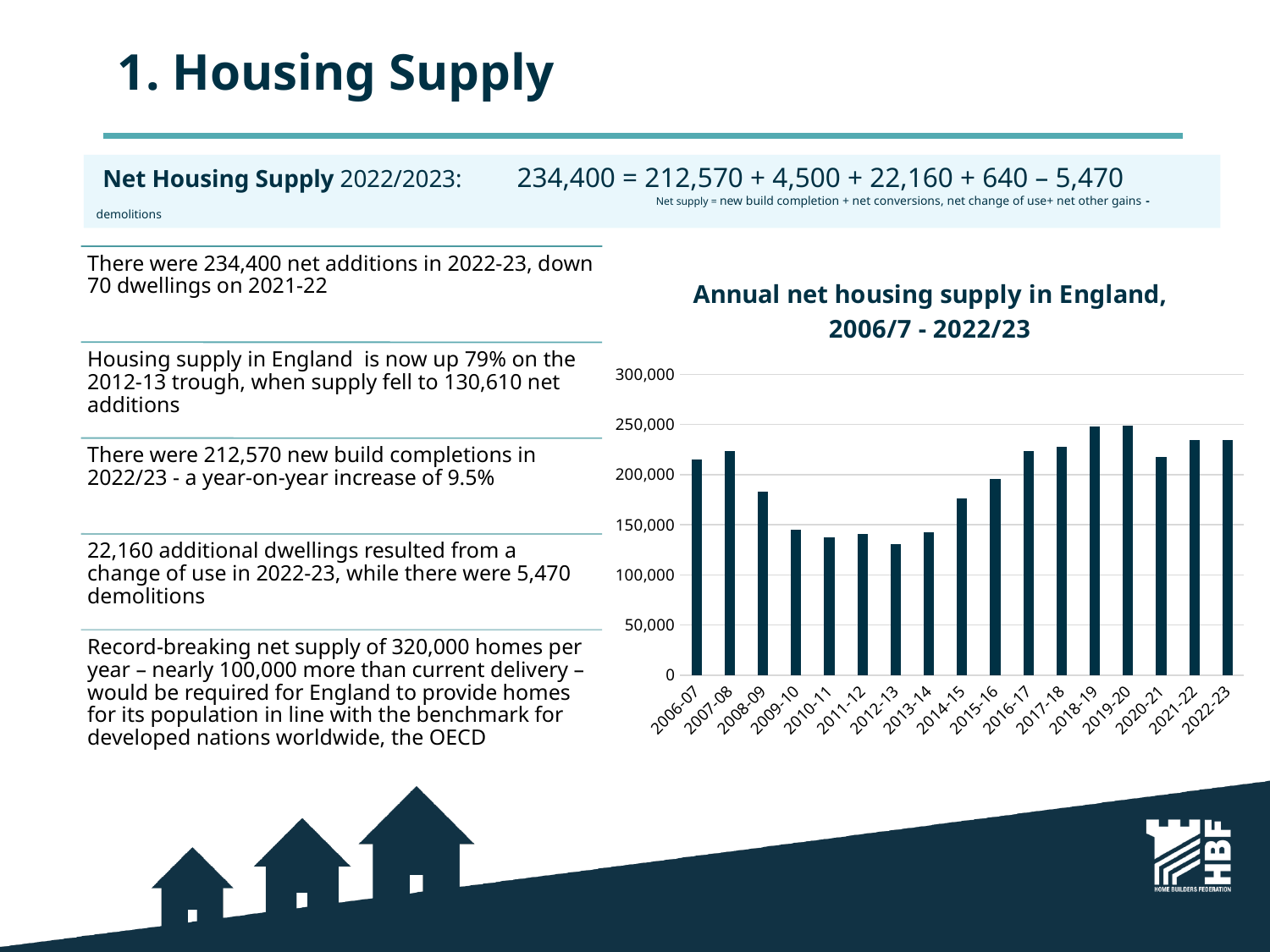
What kind of chart is shown on the slide? bar chart Is the value for 2012-13 greater or less than 150,000? less Is the value for 2006-07 greater or less than 200,000? greater Do the values rise or fall from 2012-13 to 2018-19? rise What is the title of the chart? Annual net housing supply in England, 2006/7 - 2022/23 How many years (bars) are plotted in the chart? 17 Is the value for 2014-15 greater or less than 200,000? less What is the highest value shown on the chart's vertical axis? 300,000 Which is larger, the value for 2020-21 or the value for 2021-22? 2021-22 Which is larger, the value for 2008-09 or the value for 2009-10? 2008-09 Which year has the lowest annual net housing supply in the chart? 2012-13